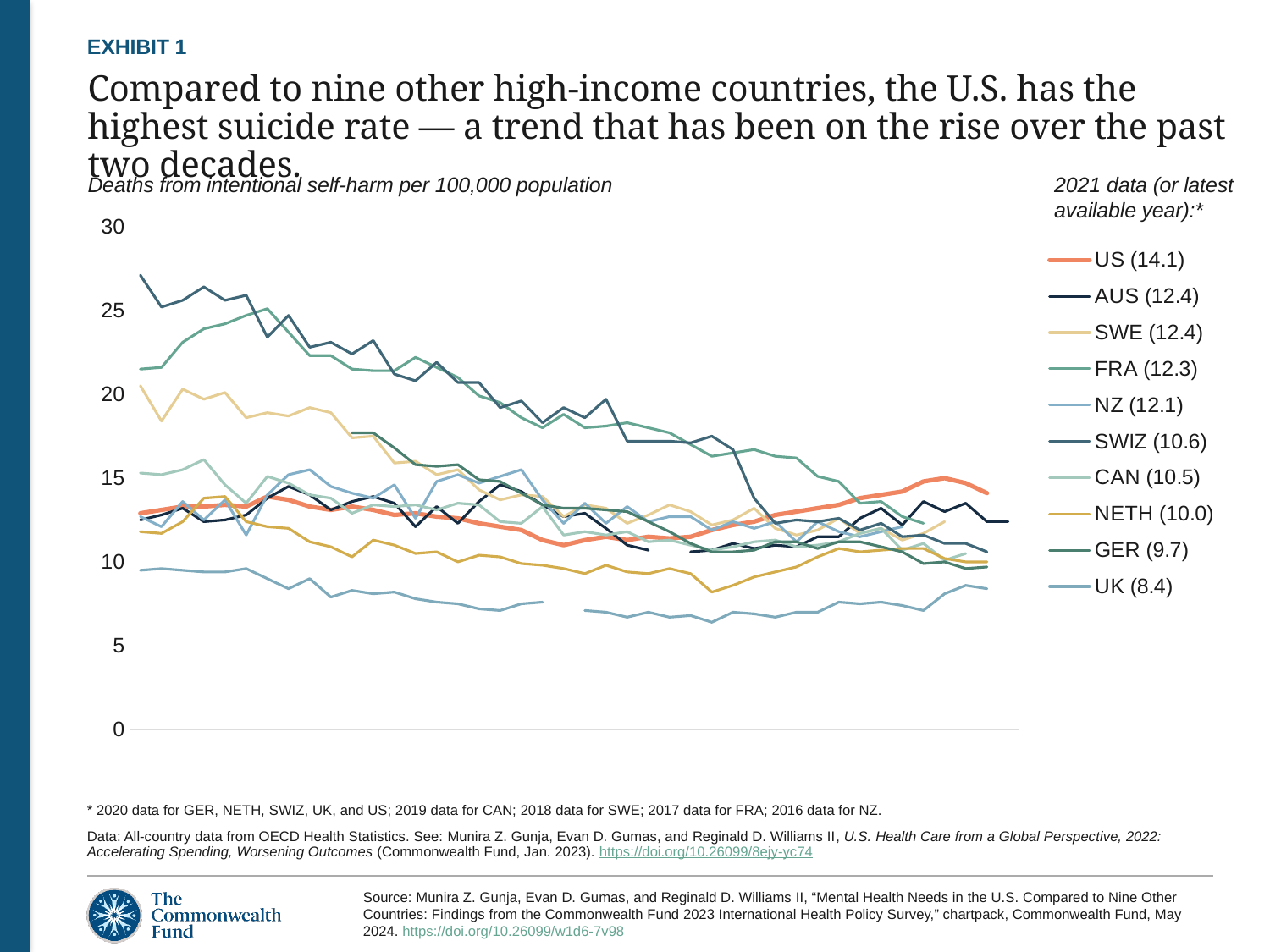
How many countries (series) does the legend list? 10 Which country has the highest latest suicide rate shown in the legend? US Which has a higher latest suicide rate, Switzerland (SWIZ) or the Netherlands (NETH)? SWIZ According to the legend, what is the latest suicide rate for Germany (GER)? 9.7 Over the period shown, does the US line generally rise or fall toward the right end of the chart? rise What does the y-axis of the chart measure, according to the subtitle? Deaths from intentional self-harm per 100,000 population What is the difference between the latest suicide rates of the US (14.1) and the UK (8.4)? 5.7 What kind of chart is shown on the slide? line chart Is the latest value for Canada (CAN) greater or less than 10? greater Which country has the lowest latest suicide rate shown in the legend? UK According to the legend, what is the latest suicide rate for the US? 14.1 According to the legend, what is the latest suicide rate for the UK? 8.4